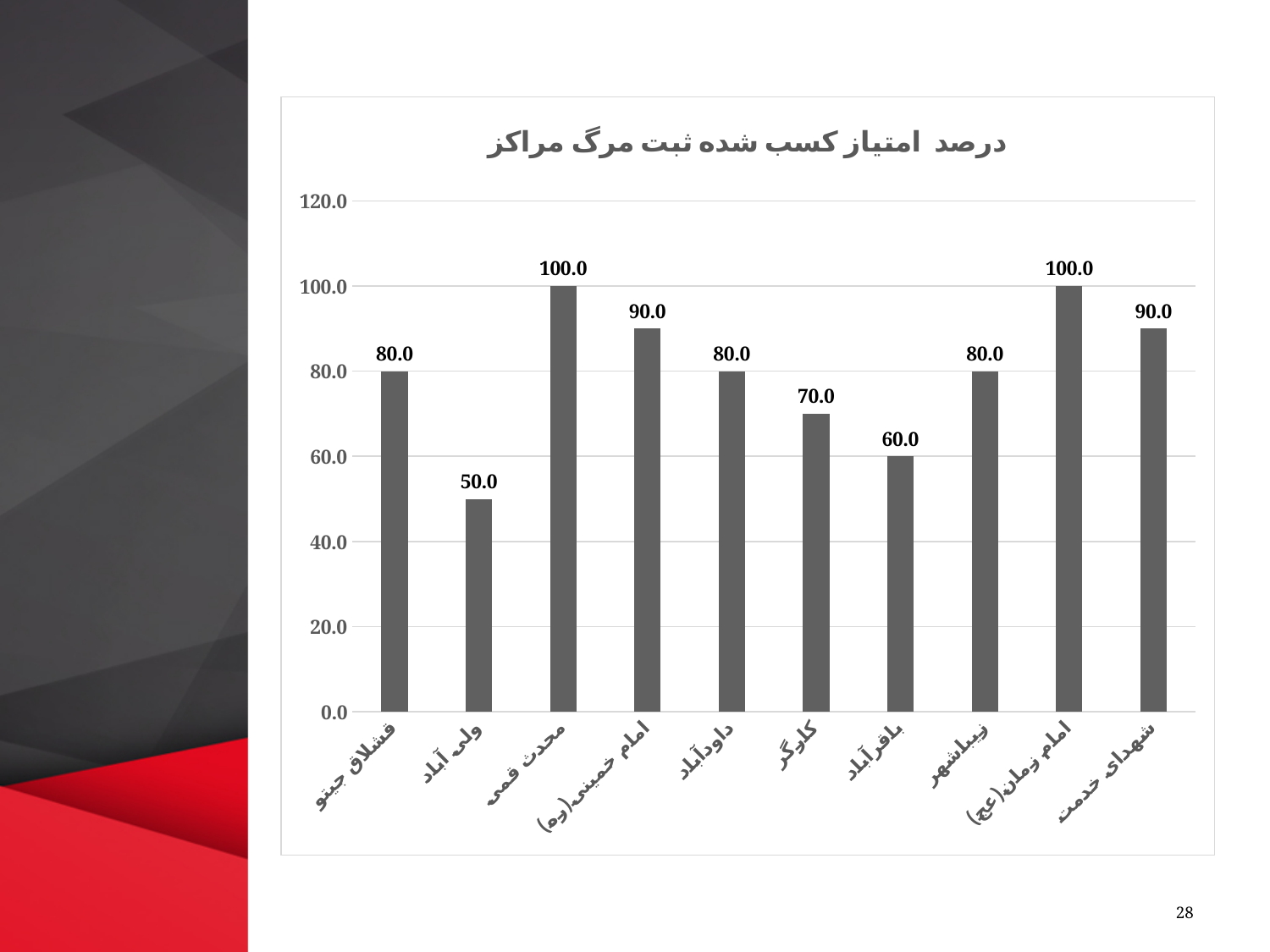
What is the value for کارگر? 70.0 What kind of chart is shown on the slide? Bar chart What is the value for شهدای خدمت? 90.0 Which is larger, the value for داودآباد or the value for باقرآباد? داودآباد Which category has the lowest value? ولی آباد What is the difference between the values for محدث قمی and ولی آباد? 50.0 What is the title of the chart? درصد امتیاز کسب شده ثبت مرگ مراکز Which two categories share the highest value of 100.0? محدث قمی and امام زمان(عج) How many categories are shown on the x axis? 10 What is the value for ولی آباد? 50.0 What is the value for باقرآباد? 60.0 What is the difference between the values for امام خمینی(ره) and کارگر? 20.0